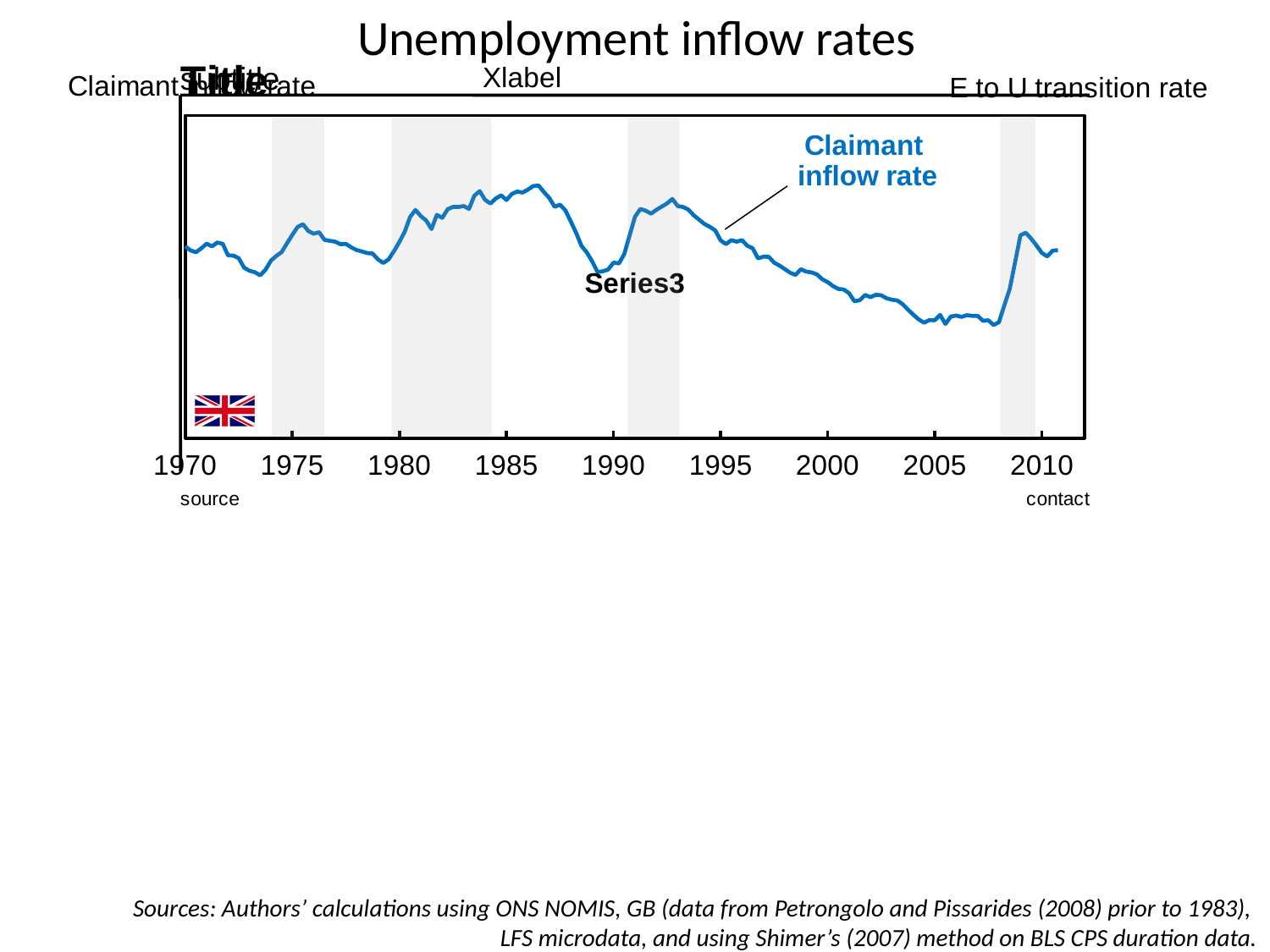
How many year labels are shown on the x axis? 9 What label is attached to the blue line in the chart? Claimant inflow rate What is the title of the chart? Unemployment inflow rates Is the claimant inflow rate higher around 1986 or around 2005? around 1986 Around which year does the claimant inflow rate reach its highest point? 1986 What is the first year labelled on the x axis? 1970 Is the claimant inflow rate higher around 1975 or around 2000? around 1975 What kind of chart is shown on the slide? line chart What is the last year labelled on the x axis? 2010 Does the claimant inflow rate rise or fall between 1995 and 2005? fall In which decade does the claimant inflow rate reach its lowest point? 2000s Does the claimant inflow rate rise or fall between 1979 and 1986? rise